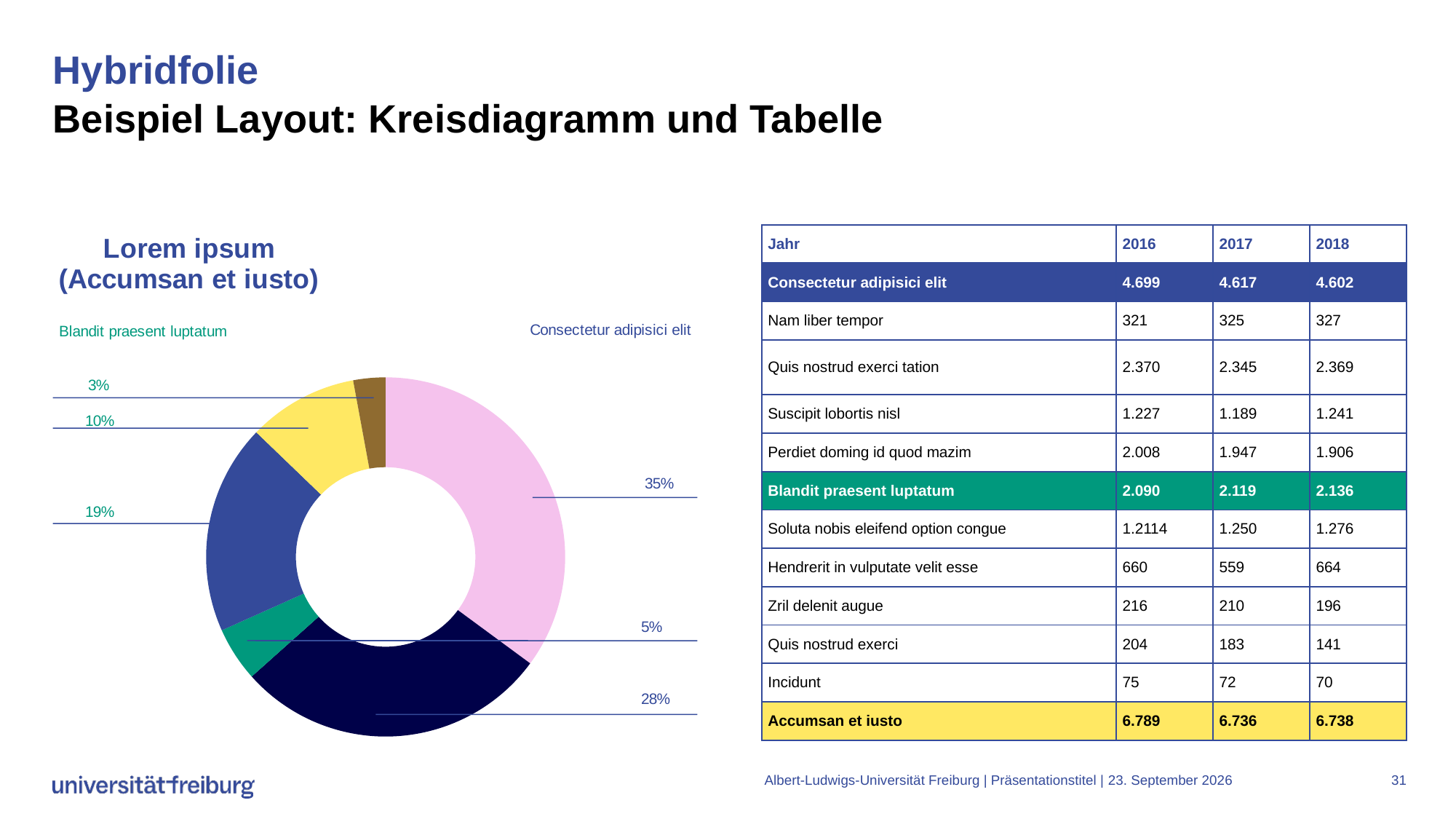
What is the difference between the largest slice (35%) and the second largest slice (28%) in the pie chart? 7% What is the difference between the 19% slice and the 5% slice in the pie chart? 14% What is the smallest percentage shown on the pie chart? 3% In the pie chart, which is larger: the 19% slice or the 10% slice? 19% Is the largest slice of the pie chart greater or less than 30%? greater What is the title of the pie chart? Lorem ipsum (Accumsan et iusto) What is the sum of the 3%, 10% and 19% slices in the pie chart? 32% How many slices does the pie chart have? 6 What kind of chart is shown on the left of the slide? pie chart (donut) What percentage is shown for the dark navy slice at the bottom of the pie chart? 28% What colour is the 35% slice of the pie chart? pink What is the largest percentage shown on the pie chart? 35%